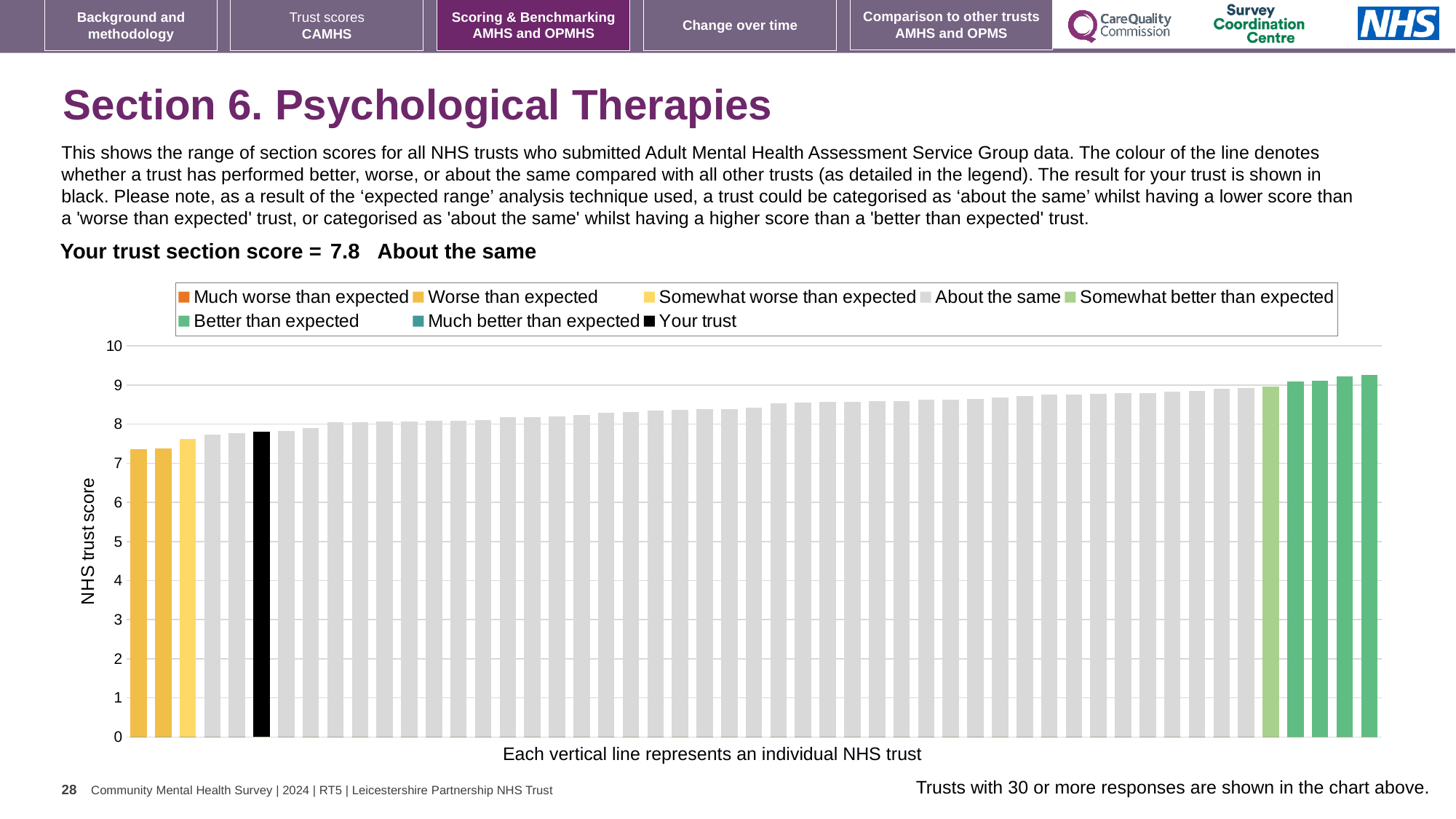
What is the label of the vertical axis? NHS trust score Which legend category does the tallest bar belong to? Better than expected How many bars are coloured as 'Better than expected'? 4 Is the value for your trust greater or less than 7? greater Is the value of the tallest bar greater or less than 9? greater How many entries does the chart legend list? 8 Which performance category is your trust placed in for this section? About the same What kind of chart is shown on the slide? bar chart Which legend category does the shortest bar belong to? Worse than expected What is the section score for your trust? 7.8 Is the value of the shortest bar greater or less than 8? less Do the bar values rise or fall from left to right along the x axis? rise